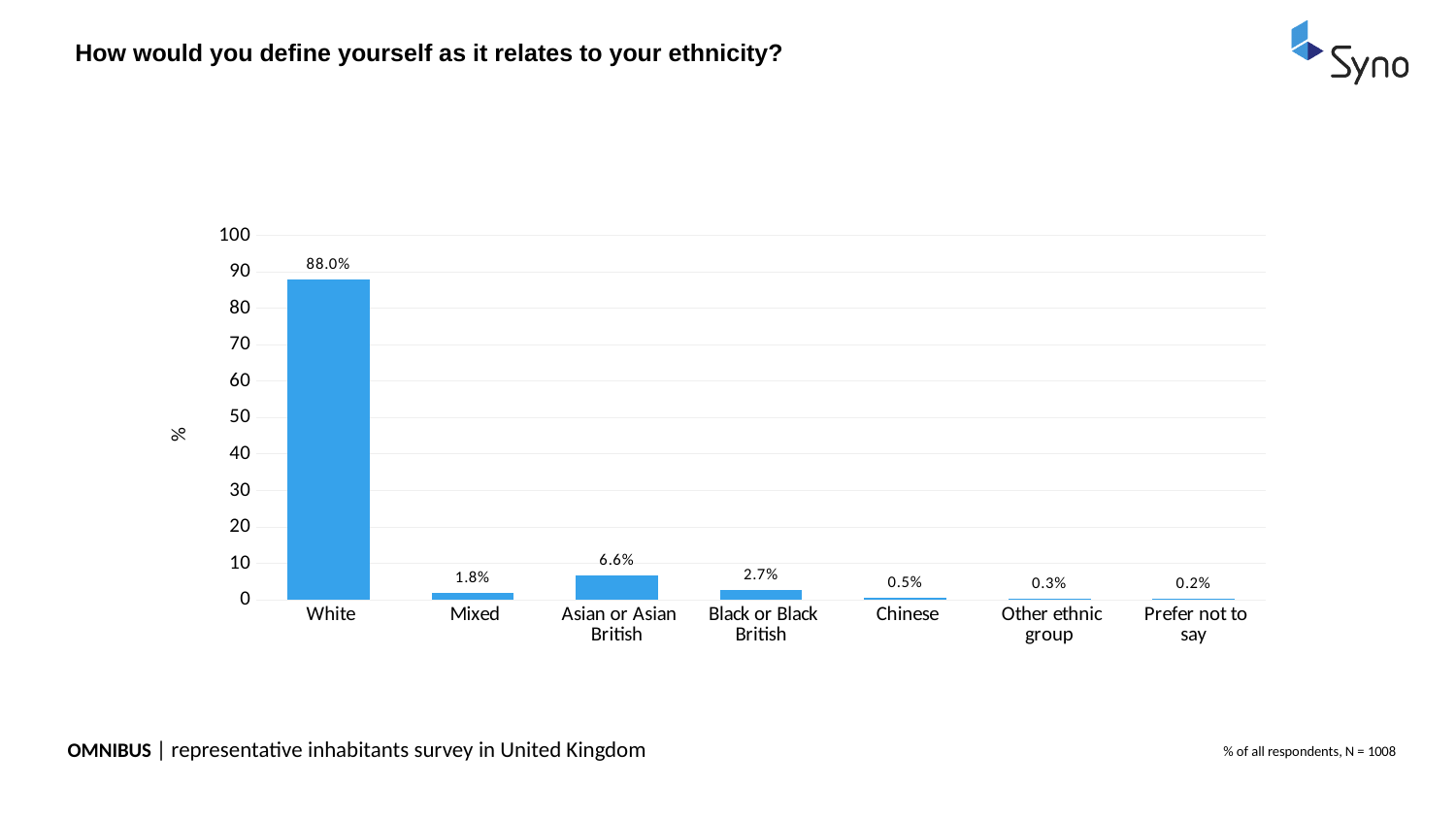
How many ethnicity categories are shown on the x axis? 7 Is the value for White greater or less than 80? greater Which is larger, the value for Mixed or the value for Chinese? Mixed What percentage of respondents chose Prefer not to say? 0.2% What kind of chart is shown on the slide? Bar chart What is the label on the y axis? % What is the value for Asian or Asian British? 6.6% Which ethnicity category has the highest value? White What is the difference between the values for Asian or Asian British and Black or Black British? 3.9% What is the value for Black or Black British? 2.7% Which category has the lowest value? Prefer not to say What percentage of respondents defined themselves as White? 88.0%